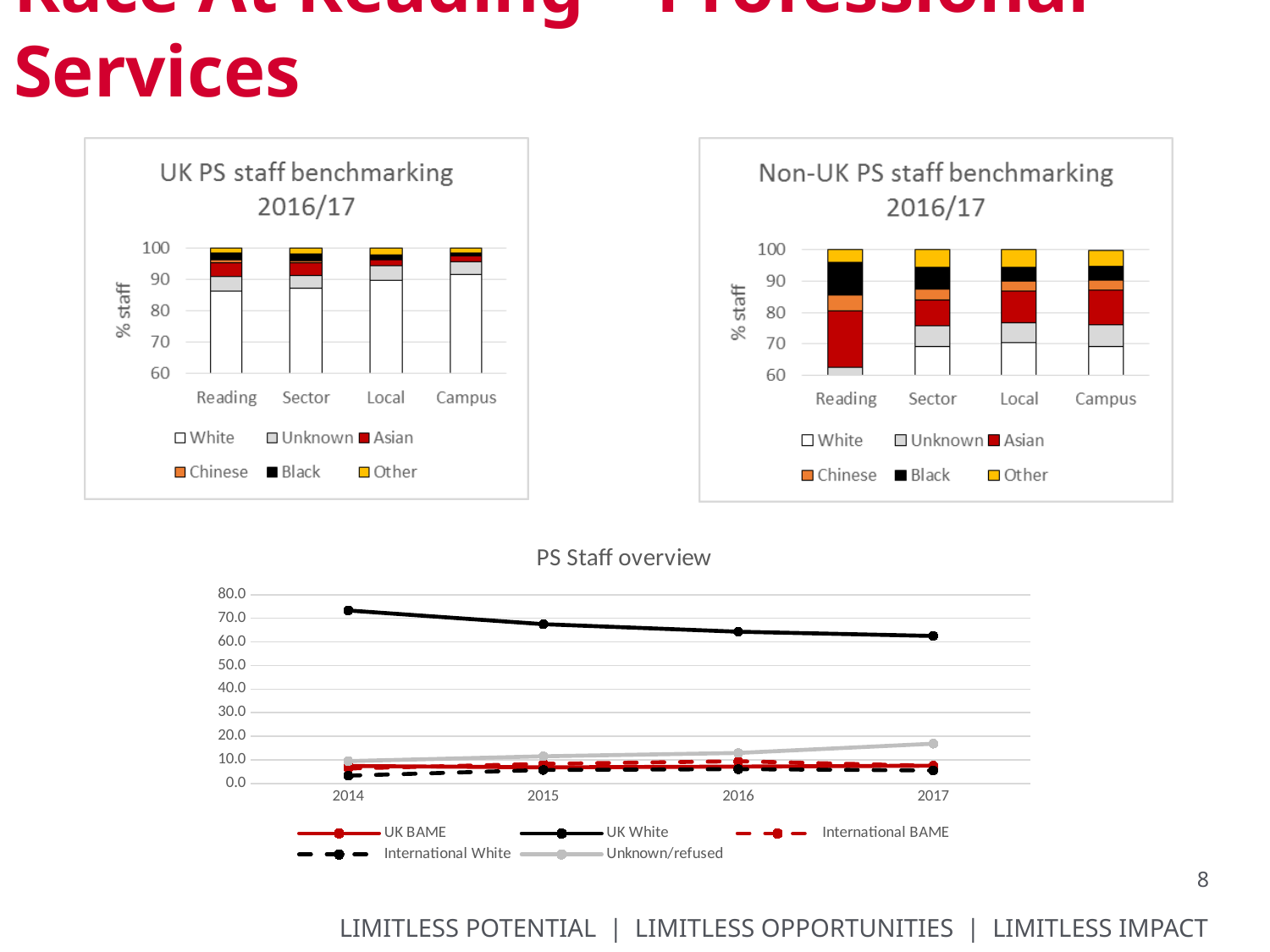
In the 'PS Staff overview' chart, which is larger in 2017: UK White or Unknown/refused? UK White In the 'UK PS staff benchmarking 2016/17' chart, is the White value for Reading greater or less than 80? greater In the 'PS Staff overview' chart, is the UK White value for 2014 greater or less than 70.0? greater What kind of chart is the 'UK PS staff benchmarking 2016/17' chart? bar chart In the 'PS Staff overview' chart, how many years are shown on the x axis? 4 What kind of chart is the 'PS Staff overview' chart? line chart In the 'PS Staff overview' chart, does the UK White series rise or fall from 2014 to 2017? fall In the 'Non-UK PS staff benchmarking 2016/17' chart, which category has the lowest White value? Reading In the 'Non-UK PS staff benchmarking 2016/17' chart, is the White value for Reading greater or less than 70? less In the 'UK PS staff benchmarking 2016/17' chart, how many categories are shown on the x axis? 4 In the 'UK PS staff benchmarking 2016/17' chart, how many series does the legend list? 6 In the 'PS Staff overview' chart, how many series does the legend list? 5